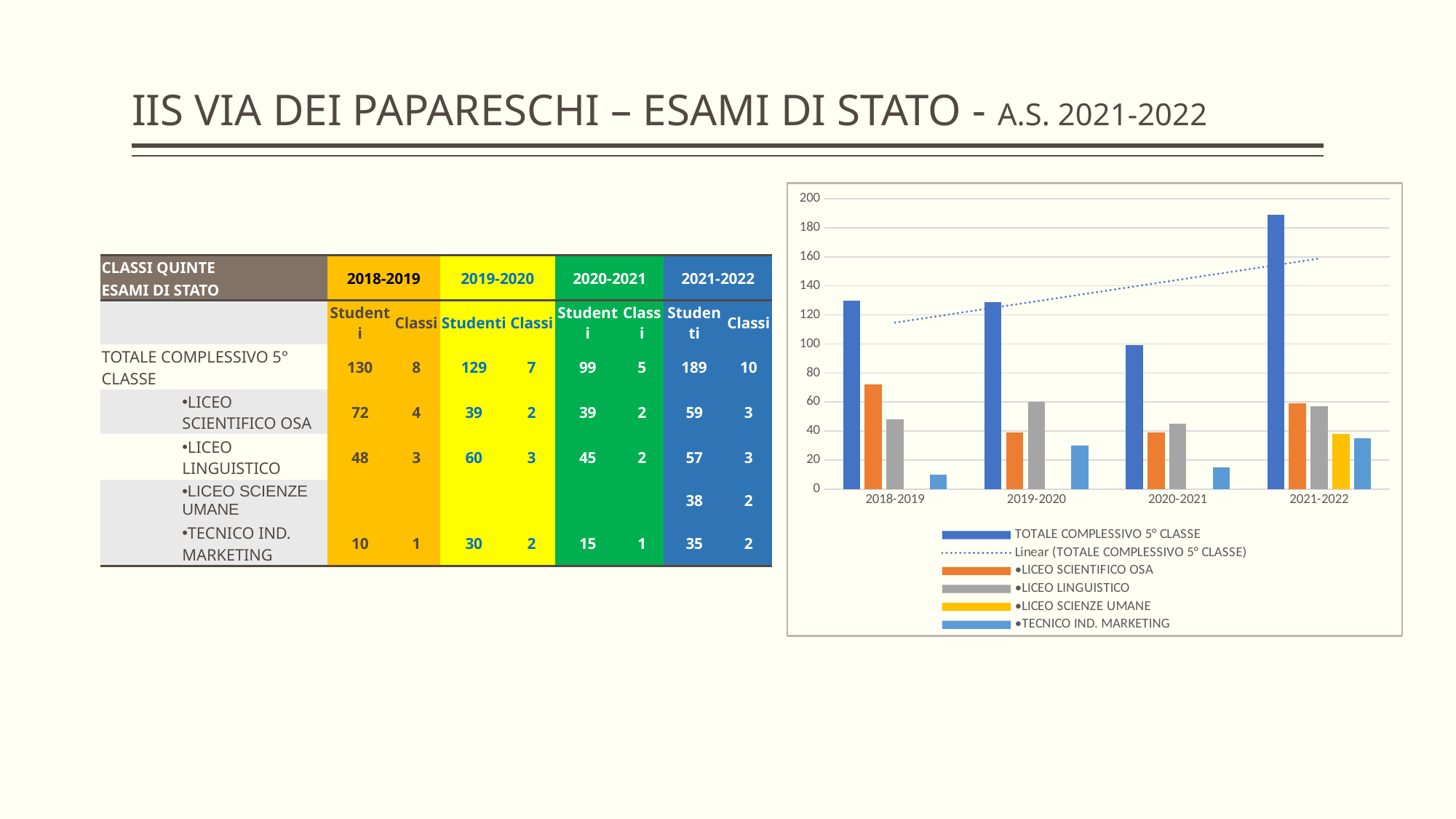
What kind of chart is shown on the right of the slide? bar chart How many entries does the chart's legend list? 6 Is the TECNICO IND. MARKETING value for 2018-2019 greater or less than 20? less Which series is shown in yellow in the chart? LICEO SCIENZE UMANE Is the TOTALE COMPLESSIVO 5° CLASSE value for 2021-2022 greater or less than 180? greater Does the dotted linear trend line for TOTALE COMPLESSIVO 5° CLASSE rise or fall across the school years? rises What is the TOTALE COMPLESSIVO 5° CLASSE number of students for 2021-2022? 189 Is the LICEO SCIENTIFICO OSA value for 2018-2019 greater or less than 60? greater In 2019-2020, which is larger: LICEO LINGUISTICO or LICEO SCIENTIFICO OSA? LICEO LINGUISTICO In which school year is the TOTALE COMPLESSIVO 5° CLASSE bar lowest? 2020-2021 In which school year is the TOTALE COMPLESSIVO 5° CLASSE bar highest? 2021-2022 How many school years are shown on the x axis of the chart? 4